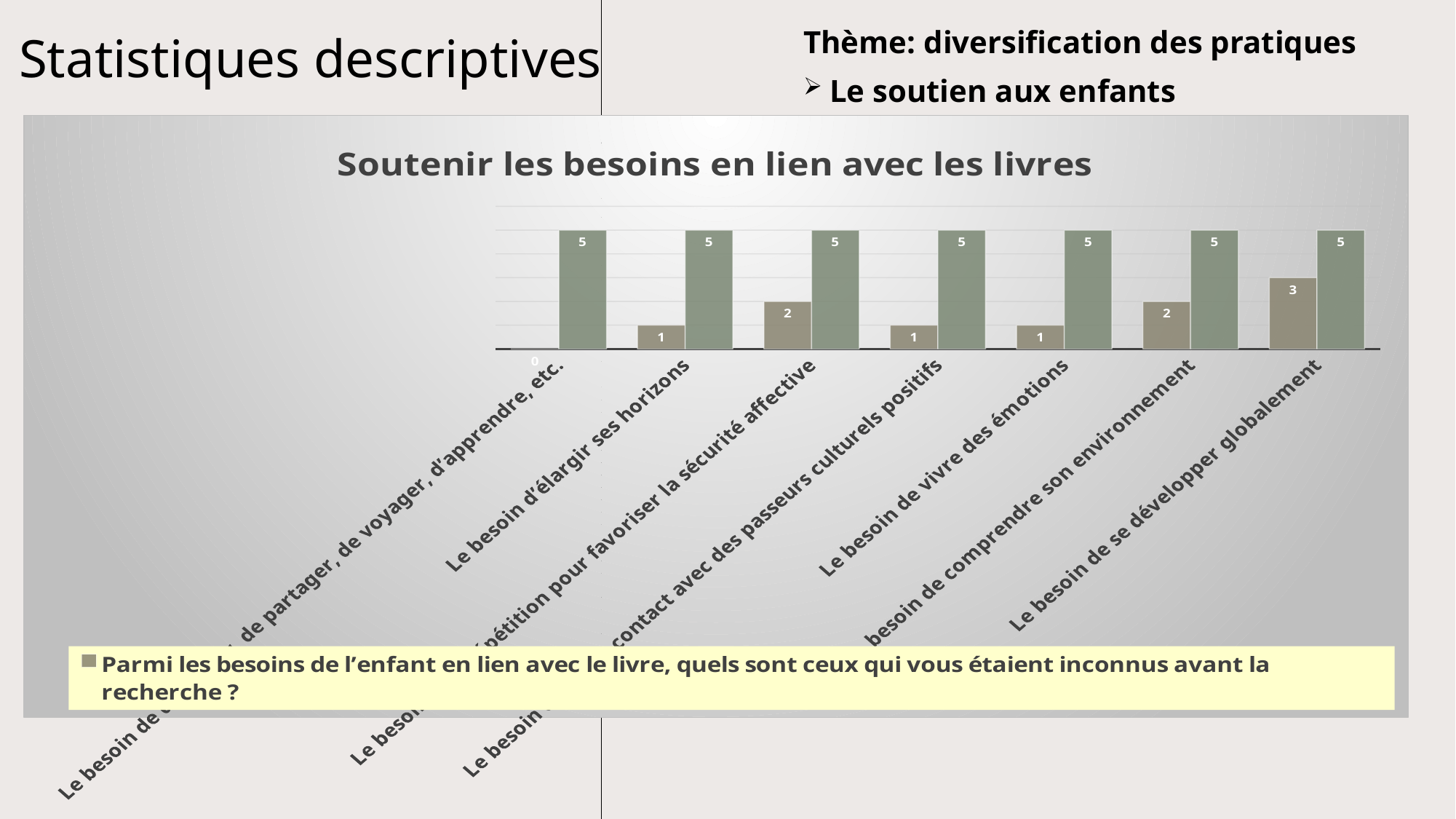
What is the value of the tan (first) bar for "Le besoin d'élargir ses horizons"? 1 What is the value of the green (second) bar for "Le besoin de comprendre son environnement"? 5 What type of chart is shown on the slide? bar chart What is the value of the green (second) bar for "Le besoin de vivre des émotions"? 5 How many categories are shown on the x axis of the chart? 7 What is the value of the tan (first) bar for "Le besoin de vivre des émotions"? 1 Which is larger for "Le besoin d'élargir ses horizons": the tan bar or the green bar? the green bar What is the title of the chart? Soutenir les besoins en lien avec les livres What is the value of the tan (first) bar for "Le besoin de se développer globalement"? 3 What is the difference between the green bar and the tan bar for "Le besoin de se développer globalement"? 2 Which category has the highest value for the tan (first) bar? Le besoin de se développer globalement What is the difference between the tan bar for "Le besoin de se développer globalement" and the tan bar for "Le besoin de vivre des émotions"? 2